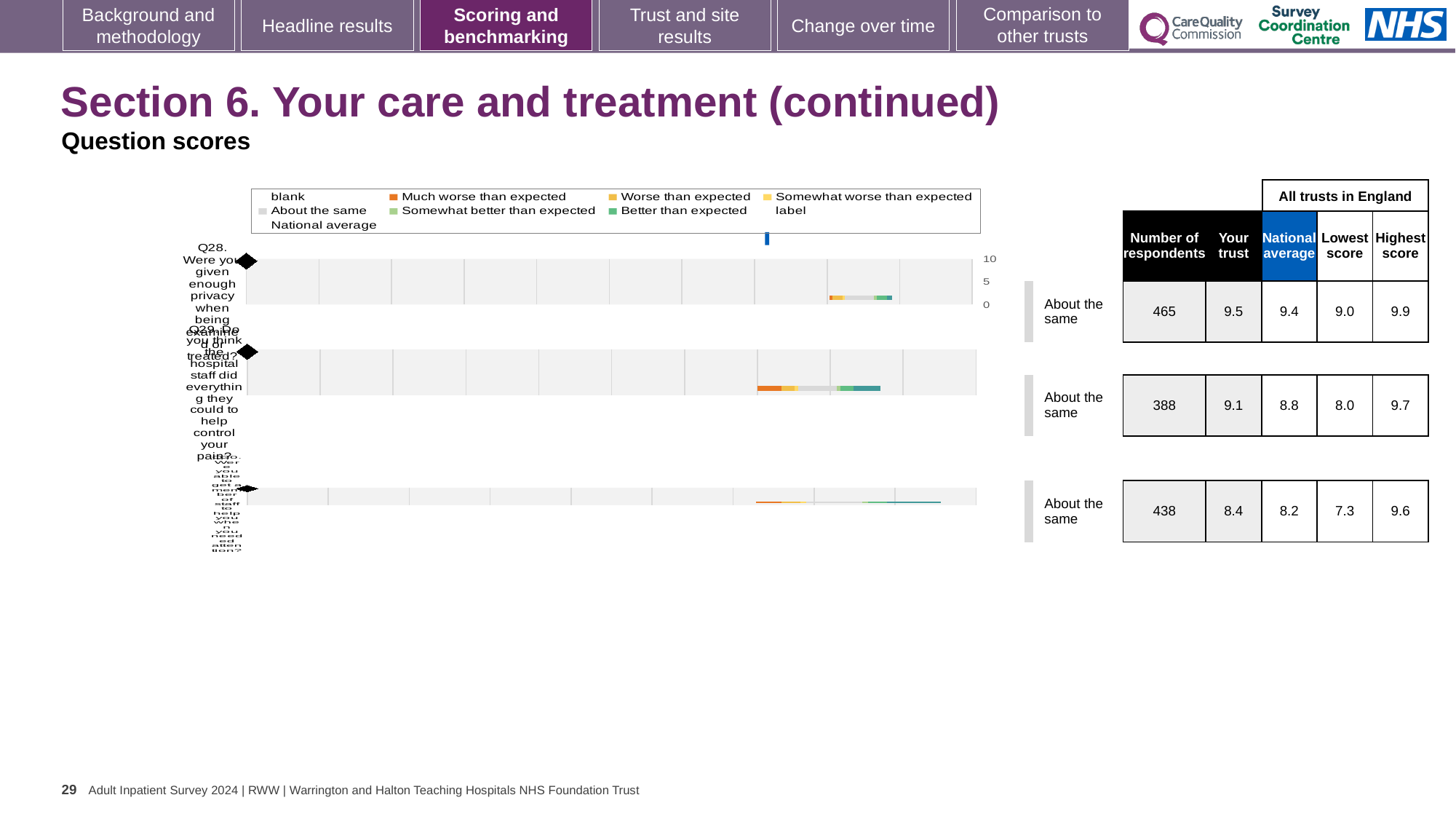
What is the national average score for Q29 (hospital staff helping control your pain)? 8.8 What is the difference between the highest score and the lowest score for Q28? 0.9 What heading appears above the National average, Lowest score and Highest score columns? All trusts in England Which question has the lowest 'Lowest score' among all trusts in England? Q30 How many respondents answered Q30 (getting a member of staff to help when needed)? 438 What kind of chart is shown on the slide for the question scores? Bar chart Which question has the highest 'Your trust' score? Q28 What is the difference between the 'Your trust' score and the national average for Q30? 0.2 What benchmark category is shown next to the bar for Q30? About the same What is the 'Your trust' score for Q28 (privacy when being examined or treated)? 9.5 For Q29, which is larger: the 'Your trust' score or the national average? Your trust How many questions (categories) are plotted in the chart? 3